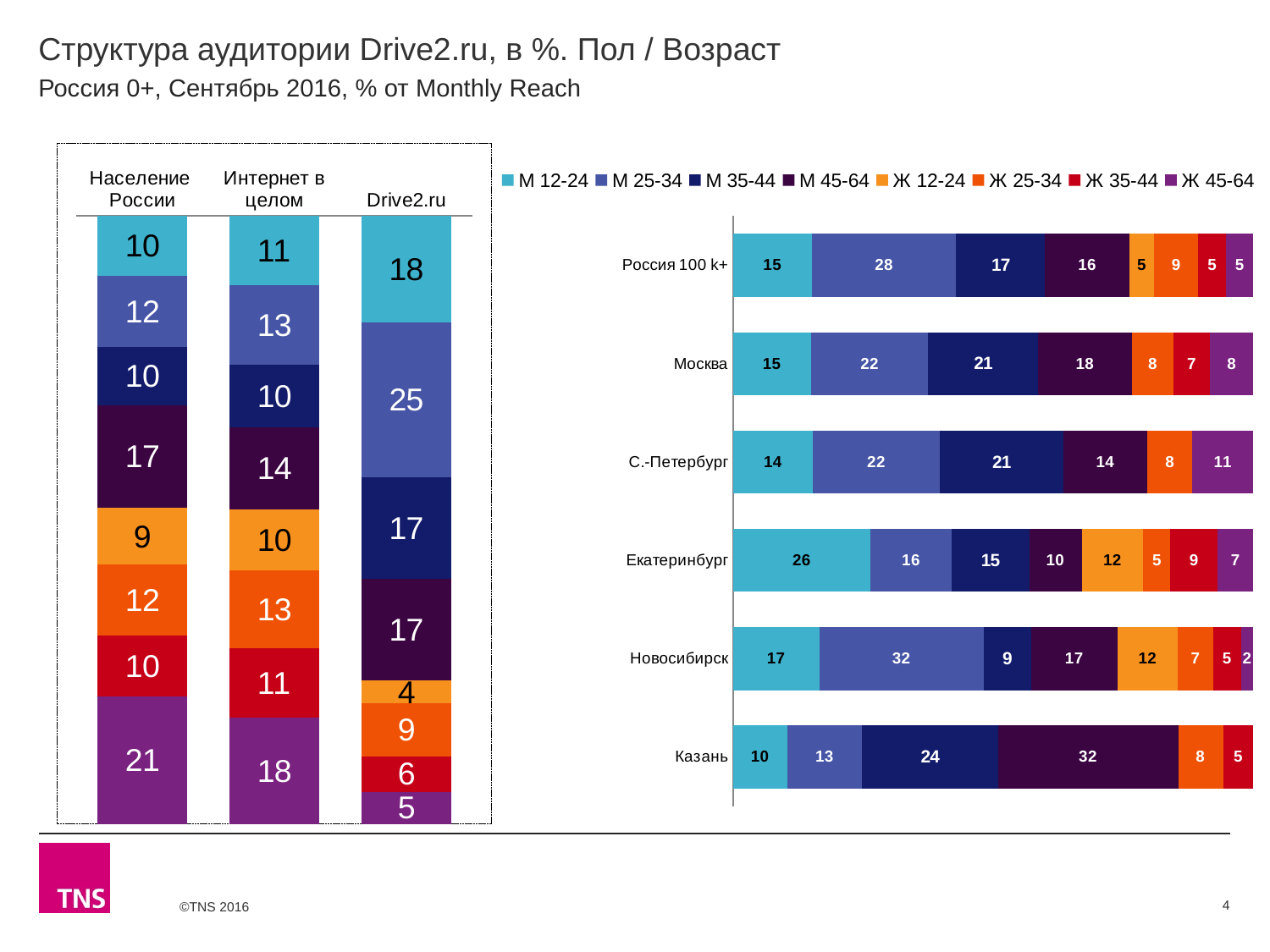
On the left chart, which segment is the smallest in the Drive2.ru bar? Ж 12-24 On the left chart, what is the difference between the М 12-24 value for Drive2.ru and for Население России? 8 On the left chart, what is the value for М 25-34 in the Drive2.ru bar? 25 On the right chart, what is the value for М 25-34 for Новосибирск? 32 On the right chart, what is the value for М 12-24 for Екатеринбург? 26 On the left chart, what is the value for Ж 45-64 in the Население России bar? 21 How many cities/regions are shown on the right chart? 6 On the left chart, which segment is the largest in the Drive2.ru bar? М 25-34 On the right chart, what is the difference between the М 25-34 value for Россия 100 k+ and for Москва? 6 How many series does the legend on the right chart list? 8 On the right chart, which segment is the largest for Россия 100 k+? М 25-34 On the right chart, which is larger: the М 35-44 value for Москва or for Россия 100 k+? Москва